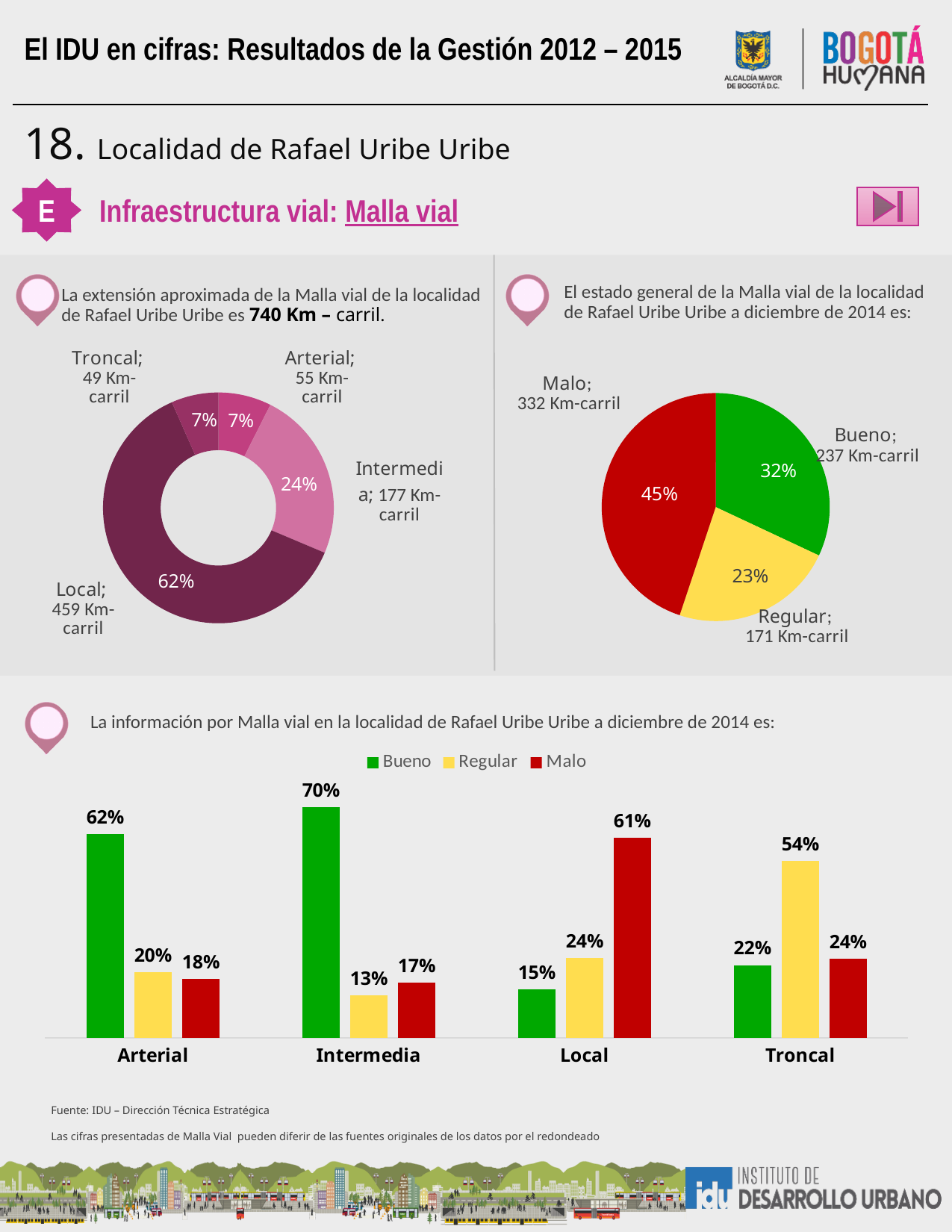
In the bar chart at the bottom, what is the Bueno value for Intermedia? 70% In the donut chart on the left, what share of the road network is Local? 62% In the bar chart at the bottom, which is larger for Arterial: Regular or Malo? Regular In the bar chart at the bottom, what is the difference between the Regular and Malo values for Troncal? 30% In the pie chart on the right, which condition has the smallest share? Regular In the pie chart on the right, what percentage of the road network is in Malo condition? 45% In the bar chart at the bottom, what is the Malo value for Local? 61% In the donut chart on the left, which category has the largest share? Local In the donut chart on the left, how many Km-carril does the Intermedia category have? 177 Km-carril In the pie chart on the right, how many slices are there? 3 In the bar chart at the bottom, how many series does the legend list? 3 In the pie chart on the right, how many Km-carril are in Bueno condition? 237 Km-carril